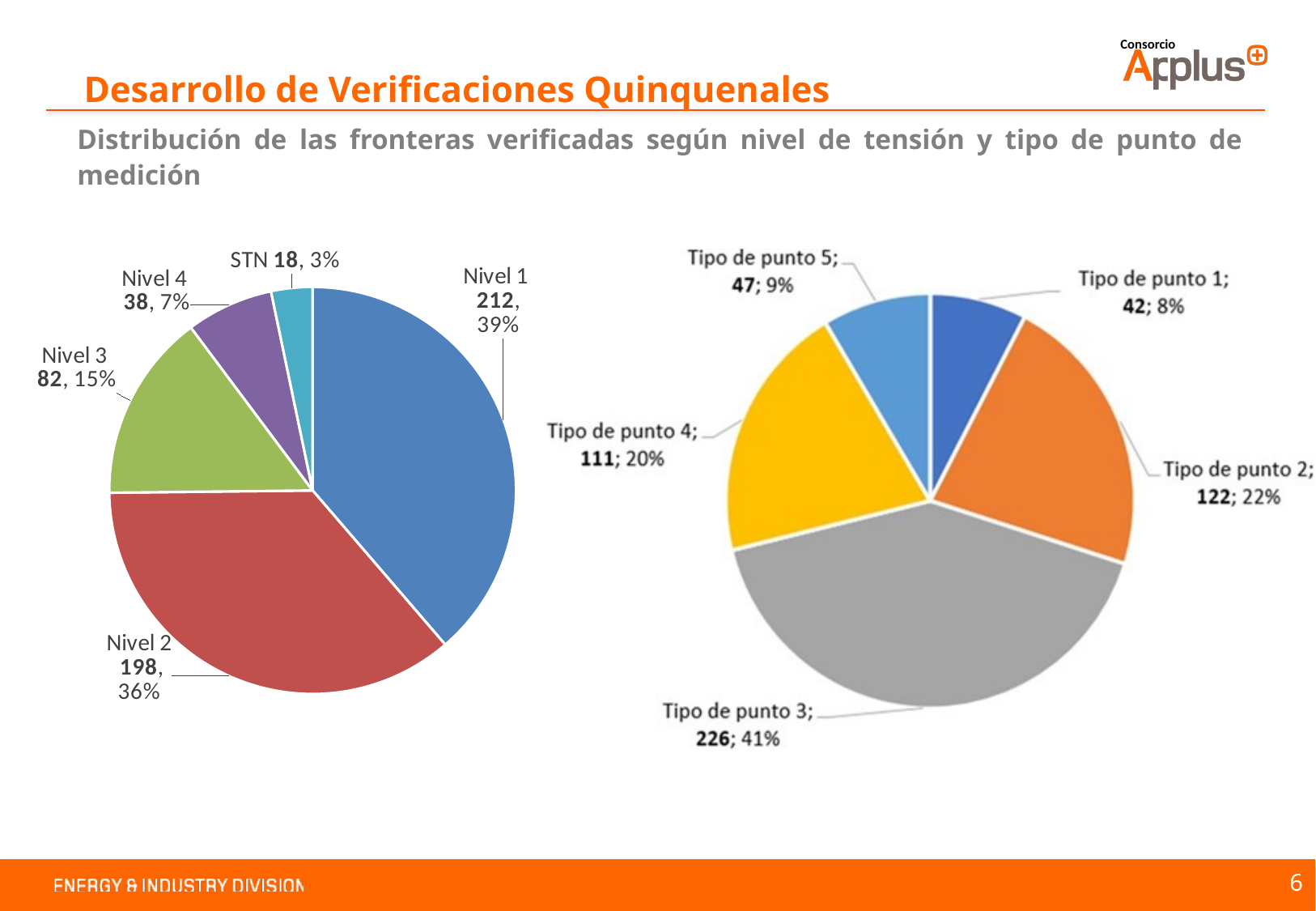
In the right pie chart, which category has the largest slice? Tipo de punto 3 What kind of chart is used on the right side of the slide? Pie chart In the right pie chart, what is the value for Tipo de punto 2? 122 In the left pie chart, what is the difference between the values for Nivel 3 and Nivel 4? 44 In the right pie chart, what is the difference between the values for Tipo de punto 3 and Tipo de punto 2? 104 In the right pie chart, which is larger, Tipo de punto 1 or Tipo de punto 5? Tipo de punto 5 In the left pie chart, how many categories are shown? 5 In the left pie chart, what is the value for Nivel 1? 212 In the left pie chart, what percentage share does Nivel 2 have? 36% In the right pie chart, what percentage share does Tipo de punto 4 have? 20% In the left pie chart, which category has the smallest slice? STN In the left pie chart, which category has the largest slice? Nivel 1